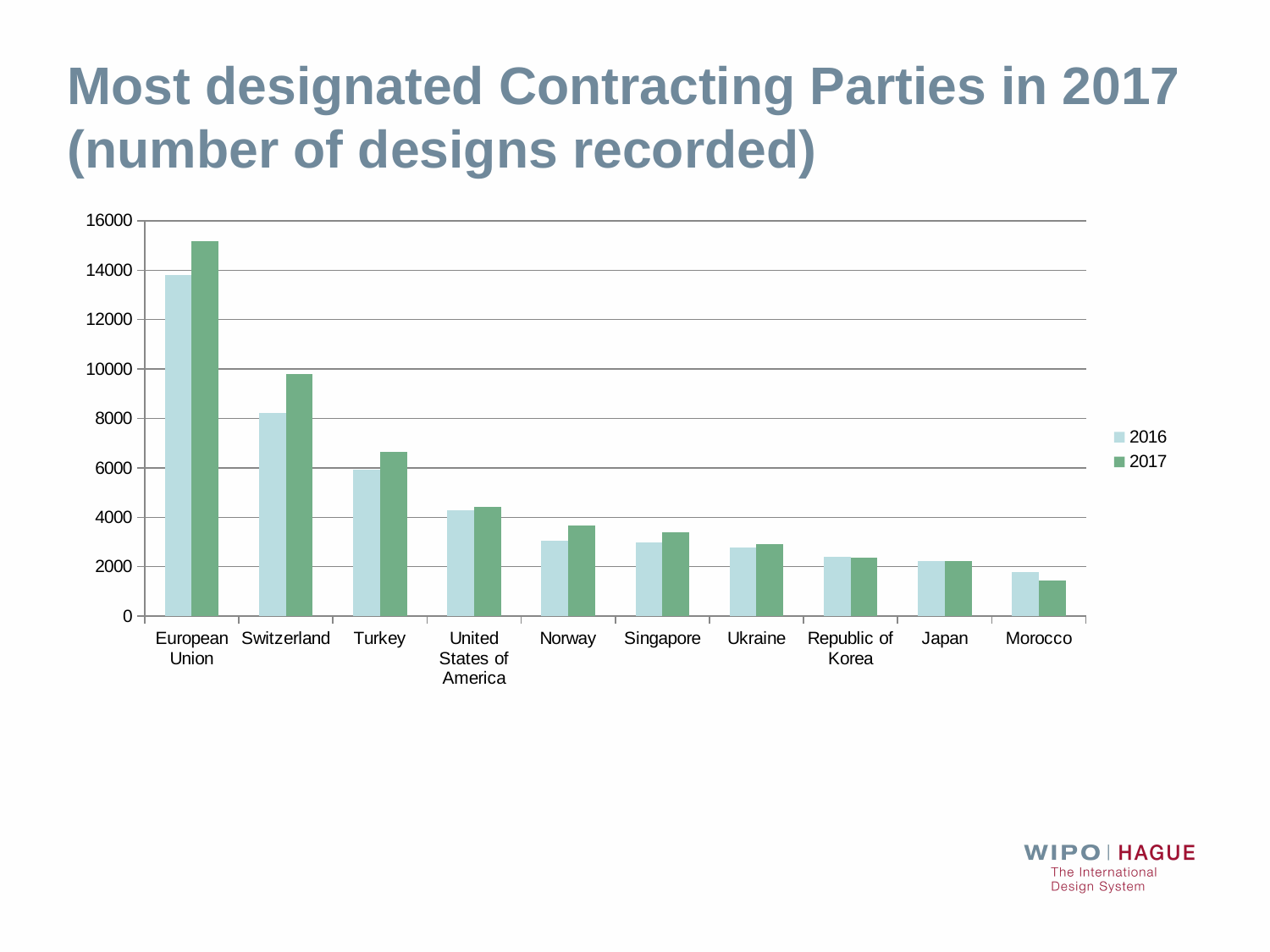
Which Contracting Party has the lowest number of designs recorded in 2017? Morocco Do the 2017 values rise or fall moving from left to right along the x axis? fall How many series does the legend list? 2 Which is larger, the 2017 value for Switzerland or the 2017 value for Turkey? Switzerland Which Contracting Party has the highest number of designs recorded in 2017? European Union Is the 2017 value for Switzerland greater or less than 10000? less Is the 2017 value for Turkey greater or less than 6000? greater Is the 2017 value for Morocco greater or less than 2000? less What is the title of the chart? Most designated Contracting Parties in 2017 (number of designs recorded) How many Contracting Parties are shown on the x axis? 10 What kind of chart is shown on the slide? bar chart